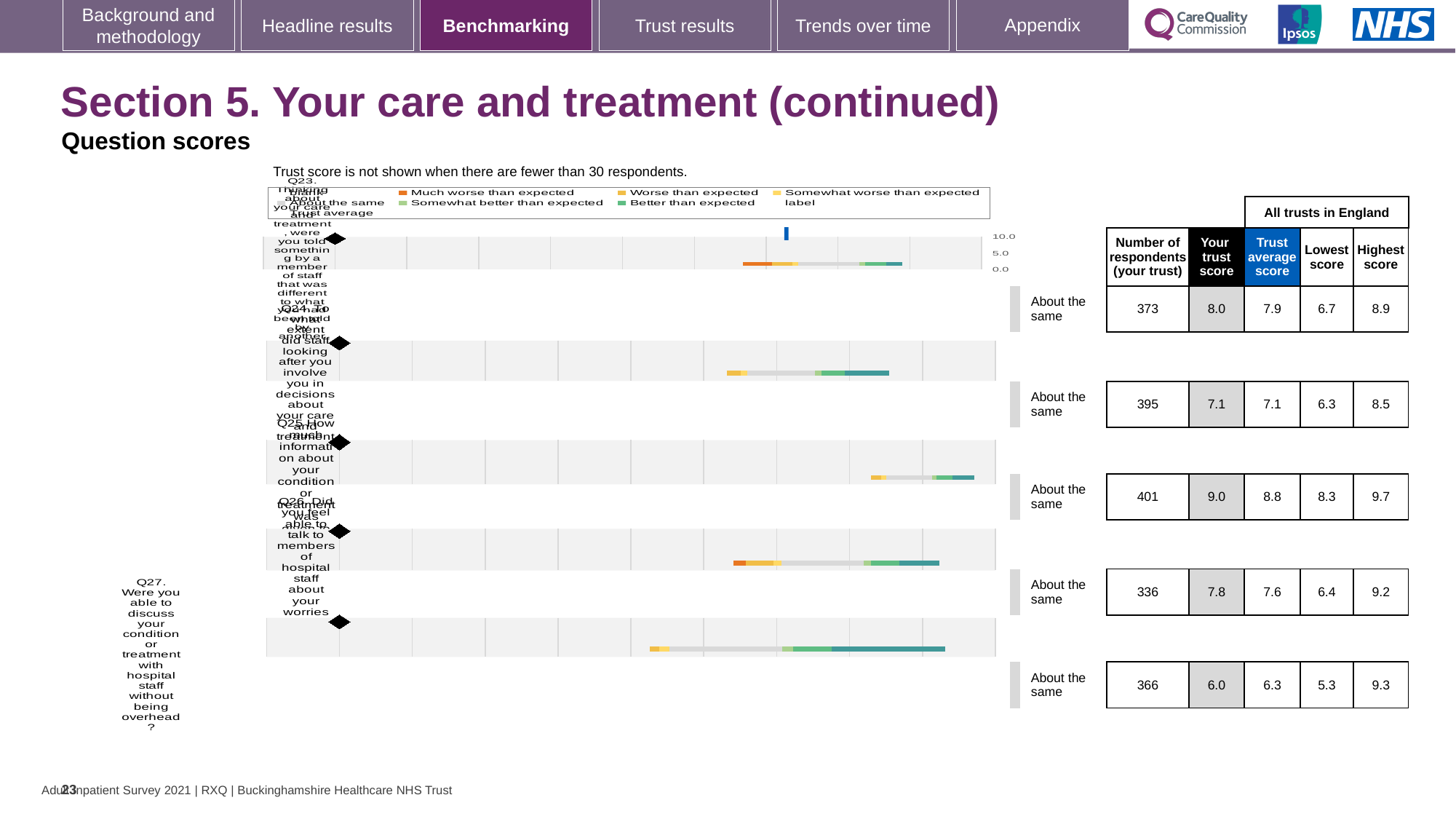
What is the lowest score across all trusts in England for Q24? 6.3 What benchmark category is shown for every question on this slide? About the same Which question has the highest trust score on this slide? Q25 For Q26, which is larger: the trust score or the trust average score? The trust score (7.8) What is the trust score for Q25 (How much information about your condition or treatment was given to you)? 9.0 How many respondents answered Q27 for this trust? 366 What is the difference between the trust score and the trust average score for Q23? 0.1 According to the note above the chart, when is the trust score not shown? When there are fewer than 30 respondents Which question has the lowest trust score on this slide? Q27 What kind of chart is used to show the question scores on this slide? Bar chart What is the highest score across all trusts in England for Q26? 9.2 How many questions (categories) are plotted in the question scores chart? 5